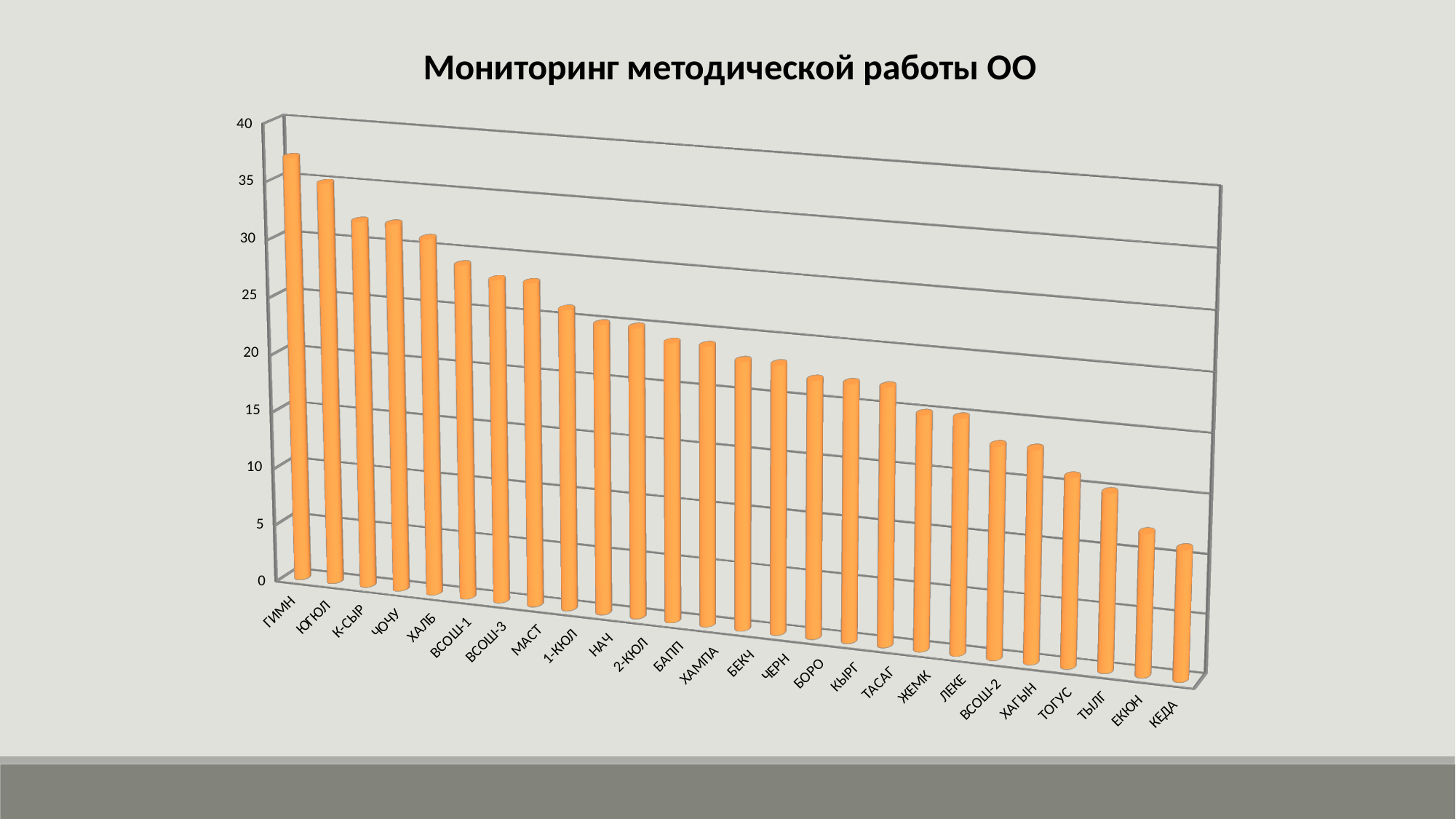
Is the value for ТЫЛГ greater or less than 10? greater How many categories are plotted on the x axis? 26 Is the value for ГИМН greater or less than 35? greater What kind of chart is shown on the slide? bar chart Which has the larger value, ЛЕКЕ or МАСТ? МАСТ Is the value for КЕДА greater or less than 5? greater Which category has the lowest value? КЕДА Which category has the highest value? ГИМН Do the values rise or fall from left to right along the x axis? fall Which has the larger value, ХАЛБ or БОРО? ХАЛБ What is the title of the chart? Мониторинг методической работы ОО